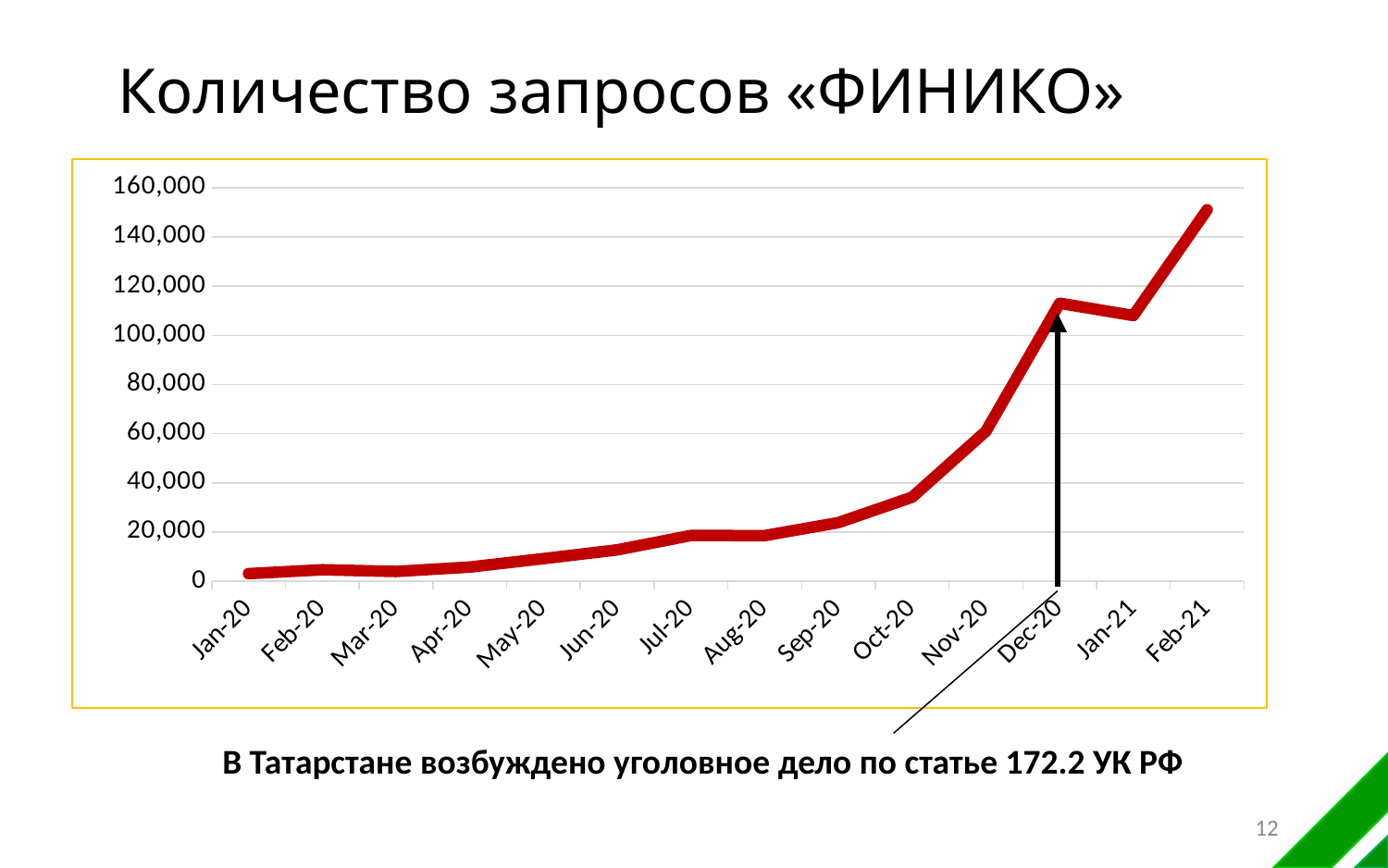
Which is higher, the value for Dec-20 or the value for Jan-21? Dec-20 What kind of chart is shown on the slide? line chart Is the value for Oct-20 greater or less than 40,000? less Which is higher, the value for Oct-20 or the value for Nov-20? Nov-20 Which month has the highest number of requests? Feb-21 What is the title of the chart? Количество запросов «ФИНИКО» Is the value for Feb-21 greater or less than 140,000? greater Is the value for Dec-20 greater or less than 100,000? greater How many months are plotted along the x axis? 14 Do the values generally rise or fall from Jan-20 to Feb-21? rise Which month is marked by the arrow annotation about the criminal case in Tatarstan? Dec-20